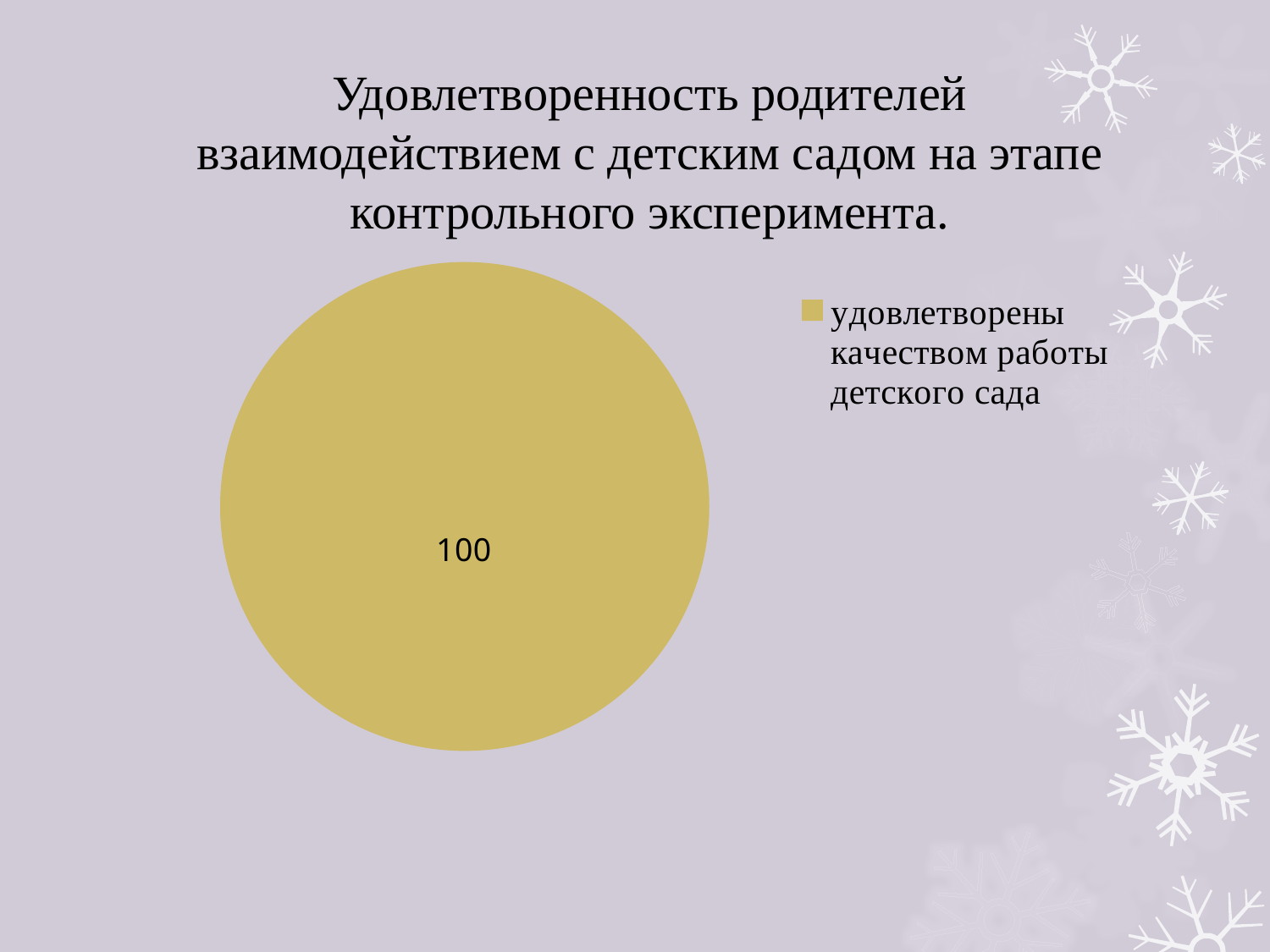
How many entries does the legend list? 1 What colour is the pie slice? yellow What is the legend entry for the pie chart? удовлетворены качеством работы детского сада What value is printed on the pie slice for "удовлетворены качеством работы детского сада"? 100 What kind of chart is shown on the slide? pie chart How many slices does the pie chart have? 1 What share of the pie does the slice "удовлетворены качеством работы детского сада" take up? 100%